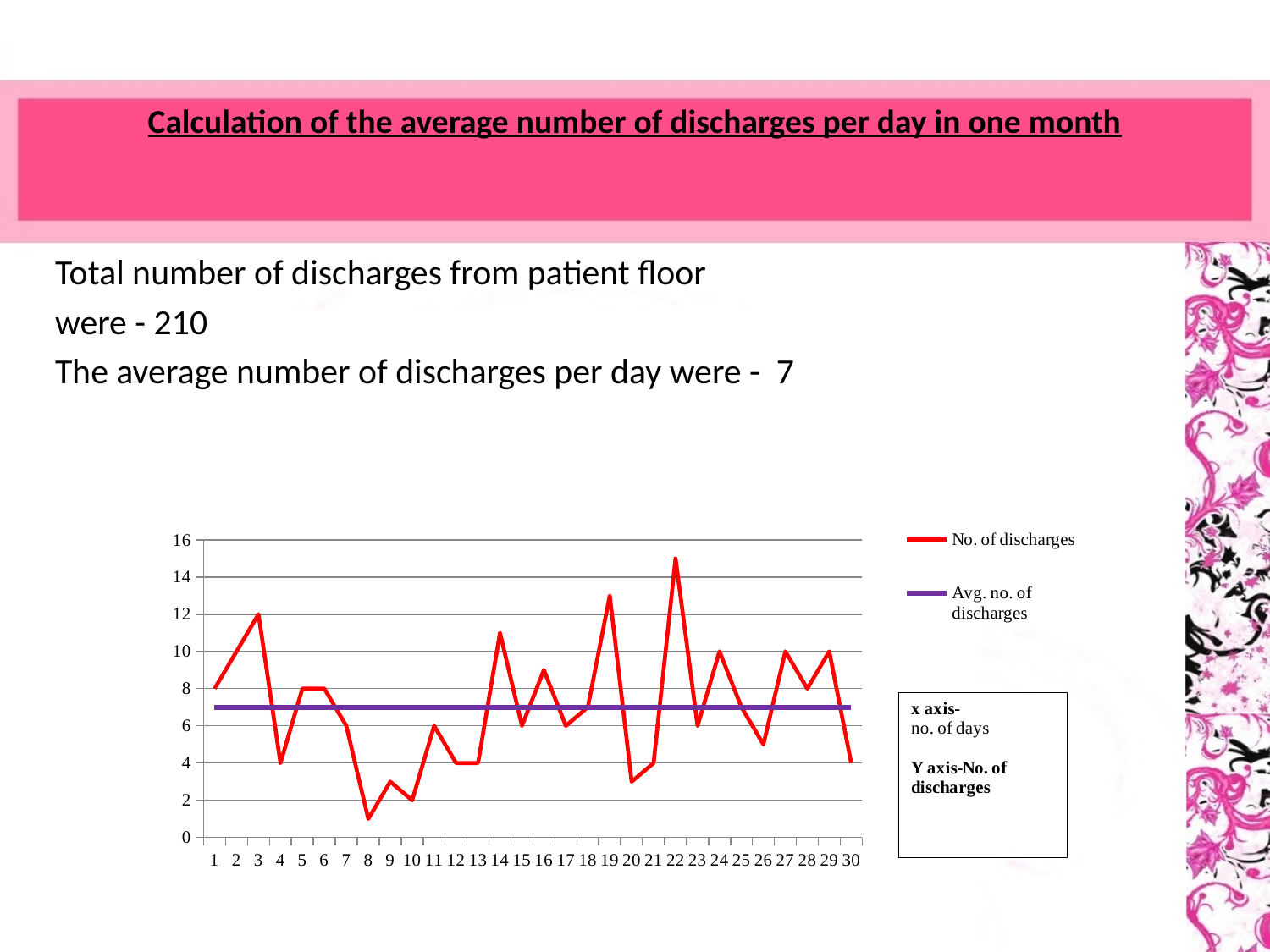
How many series does the legend list? 2 Between day 1 and day 3, does the number of discharges rise or fall? rise Which day has more discharges, day 22 or day 19? 22 What kind of chart is shown on the slide? line chart Is the number of discharges on day 22 greater or less than 14? greater How many days are plotted along the x axis? 30 On which day is the number of discharges highest? 22 What is the number of discharges on day 3? 12 On which day is the number of discharges lowest? 8 What value does the 'Avg. no. of discharges' line sit at? 7 What colour is the 'Avg. no. of discharges' line? purple Is the number of discharges on day 8 greater or less than 2? less